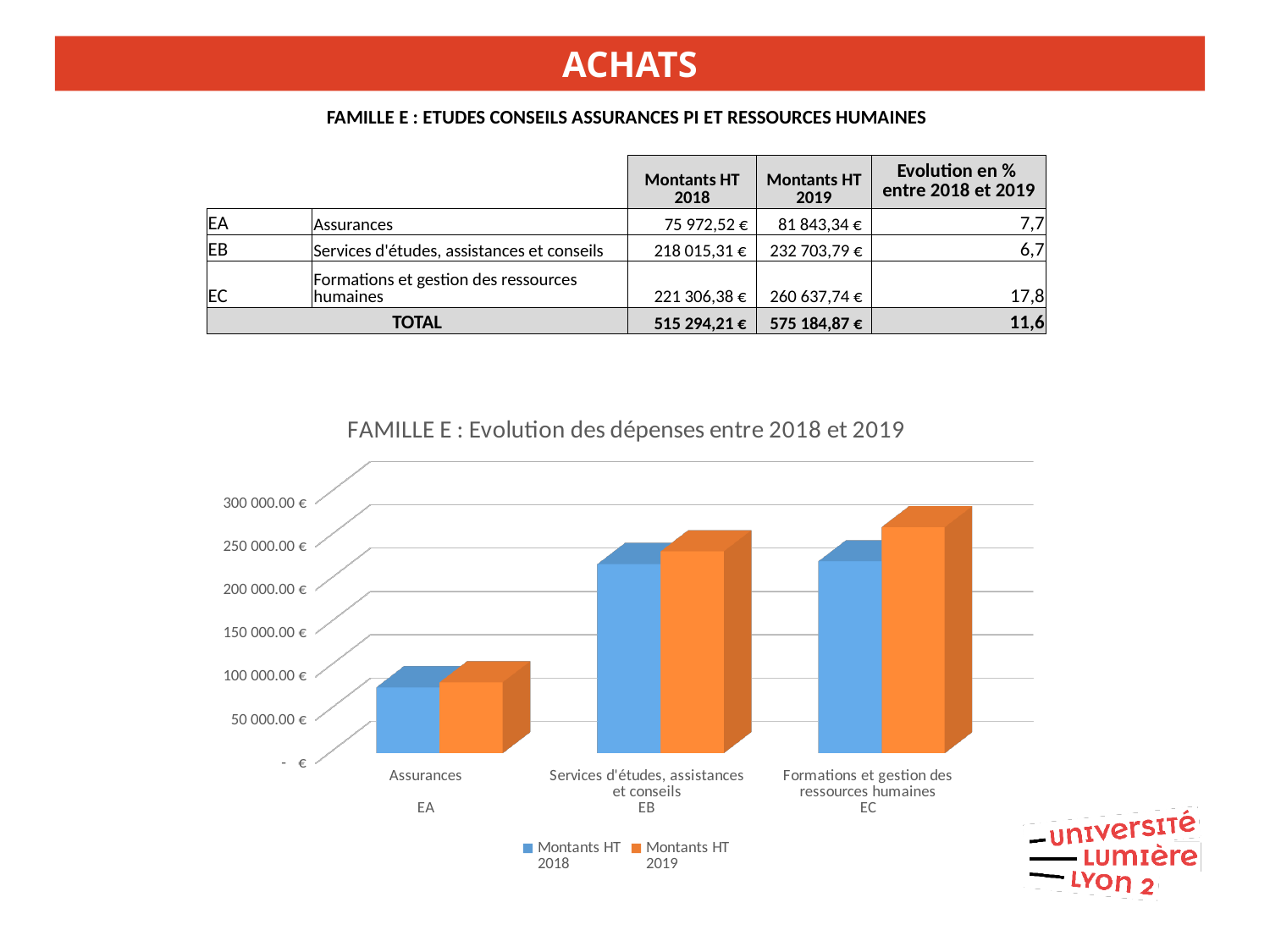
What is the Montants HT 2019 value for Formations et gestion des ressources humaines (EC)? 260 637,74 € Is the Montants HT 2019 bar for Formations et gestion des ressources humaines (EC) greater or less than 250 000.00 €? greater How many series does the chart legend list? 2 Which is larger for Services d'études, assistances et conseils (EB): Montants HT 2018 or Montants HT 2019? Montants HT 2019 How many categories are shown on the x axis of the chart? 3 Which colour represents the Montants HT 2019 series in the chart? orange What is the title of the chart? FAMILLE E : Evolution des dépenses entre 2018 et 2019 Is the Montants HT 2019 bar for Assurances (EA) greater or less than 100 000.00 €? less What kind of chart is shown on the slide? bar chart What is the Montants HT 2018 value for Assurances (EA)? 75 972,52 € Which category has the highest Montants HT 2019 value? Formations et gestion des ressources humaines (EC) Which category has the lowest Montants HT 2018 value? Assurances (EA)